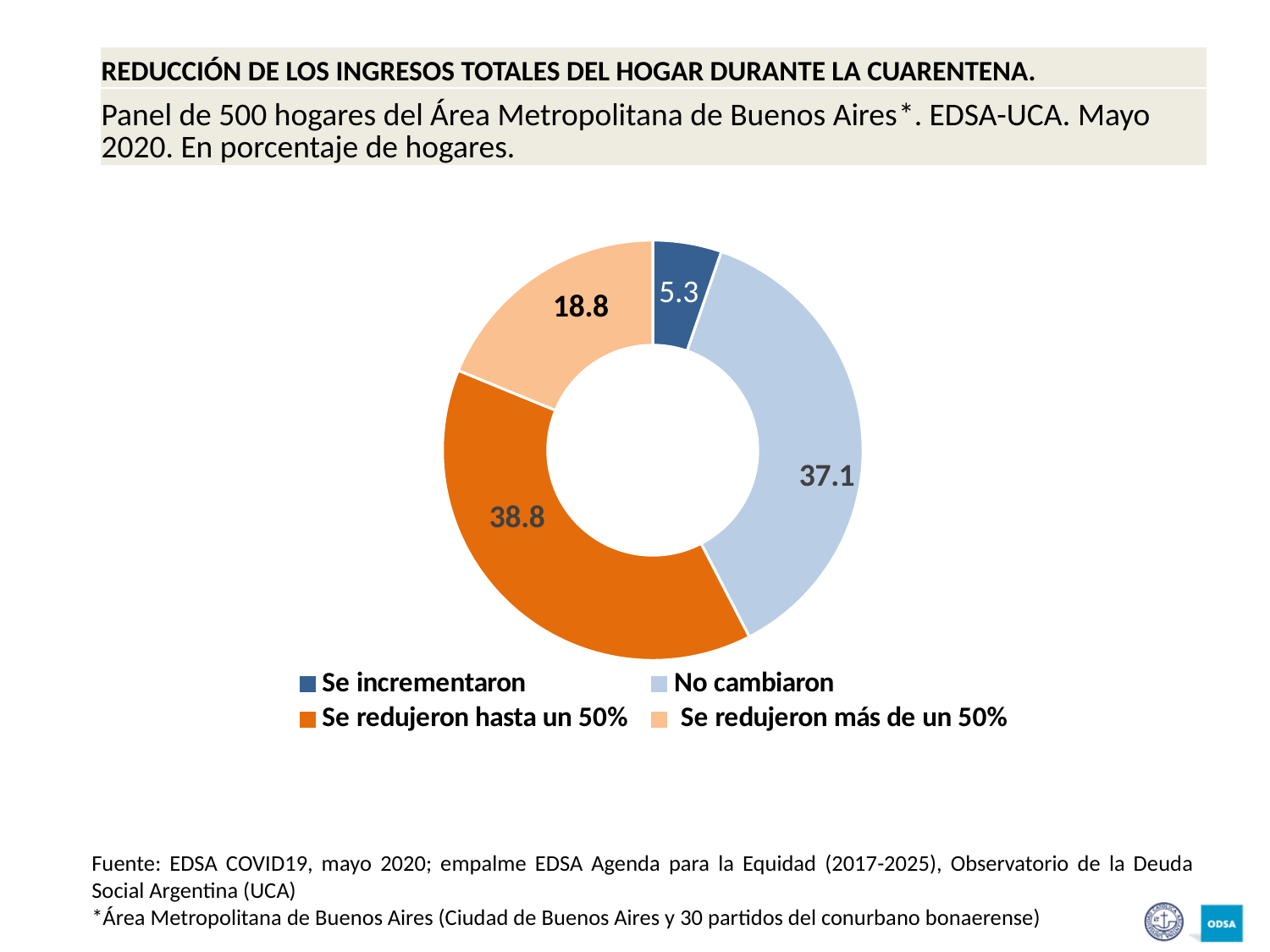
What kind of chart is shown on the slide? Doughnut (pie) chart What is the difference between the shares for "Se redujeron más de un 50%" and "Se incrementaron"? 13.5 How many categories does the chart show? 4 Which is larger: the share for "No cambiaron" or the share for "Se redujeron más de un 50%"? No cambiaron What percentage of households is shown for "Se incrementaron"? 5.3 What is the difference between the shares for "Se redujeron hasta un 50%" and "No cambiaron"? 1.7 Which category has the largest share of households? Se redujeron hasta un 50% Which colour represents "Se redujeron hasta un 50%" in the chart? Orange What percentage of households is shown for "No cambiaron"? 37.1 Which category has the smallest share of households? Se incrementaron What percentage of households is shown for "Se redujeron hasta un 50%"? 38.8 What percentage of households is shown for "Se redujeron más de un 50%"? 18.8